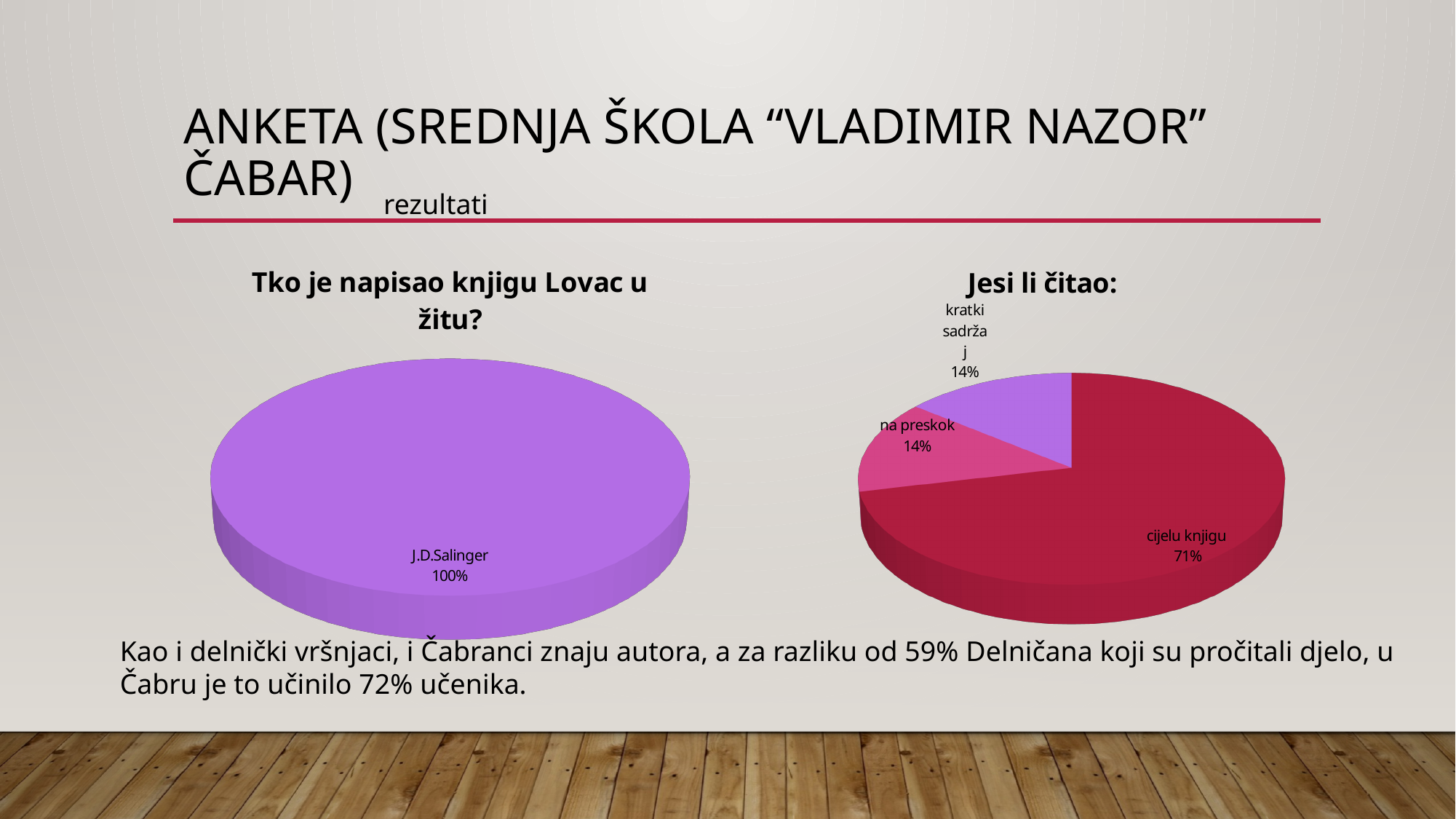
In the chart titled "Tko je napisao knjigu Lovac u žitu?", what share does J.D.Salinger have? 100% What kind of chart is the chart titled "Jesi li čitao:"? pie chart In the chart titled "Jesi li čitao:", which is larger, "cijelu knjigu" or "kratki sadržaj"? cijelu knjigu In the chart titled "Jesi li čitao:", what is the difference between the "cijelu knjigu" share and the "na preskok" share? 57% What is the title of the pie chart on the right side of the slide? Jesi li čitao: In the chart titled "Jesi li čitao:", what share is labelled "cijelu knjigu"? 71% How many slices does the chart titled "Tko je napisao knjigu Lovac u žitu?" have? 1 In the chart titled "Jesi li čitao:", which slice is the largest? cijelu knjigu In the chart titled "Jesi li čitao:", what share is labelled "kratki sadržaj"? 14% What kind of chart is the chart titled "Tko je napisao knjigu Lovac u žitu?"? pie chart How many slices does the chart titled "Jesi li čitao:" have? 3